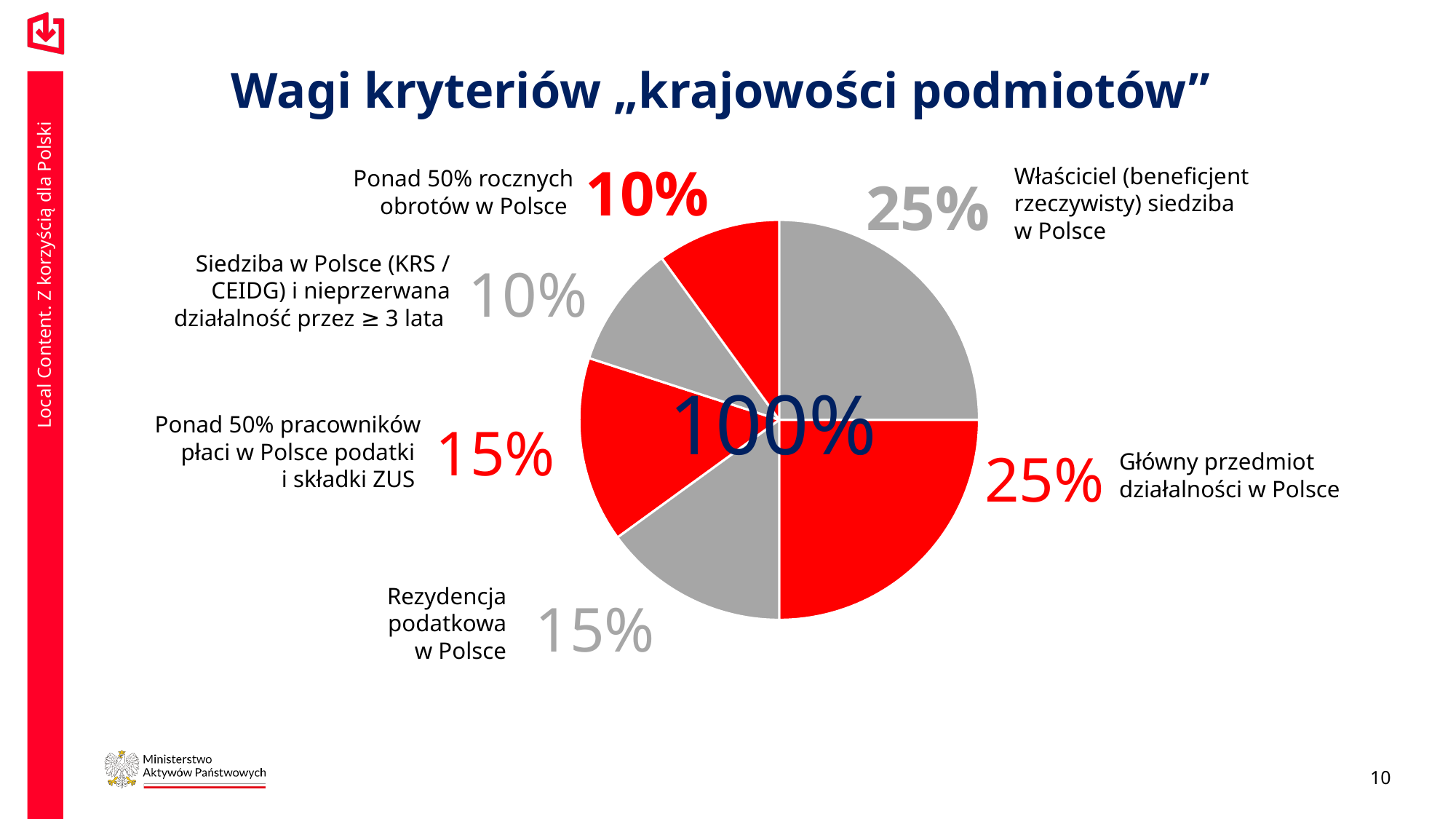
What is the weight shown for "Ponad 50% rocznych obrotów w Polsce"? 10% What is the weight shown for "Właściciel (beneficjent rzeczywisty) siedziba w Polsce"? 25% What is the difference between the weight for "Główny przedmiot działalności w Polsce" and the weight for "Ponad 50% rocznych obrotów w Polsce"? 15% What value is printed in the centre of the pie chart? 100% How many slices does the pie chart have? 6 What kind of chart is shown on the slide? pie chart Which is larger: the weight for "Rezydencja podatkowa w Polsce" or the weight for "Siedziba w Polsce (KRS / CEIDG) i nieprzerwana działalność przez ≥ 3 lata"? Rezydencja podatkowa w Polsce What is the weight shown for "Główny przedmiot działalności w Polsce"? 25% What is the weight shown for "Ponad 50% pracowników płaci w Polsce podatki i składki ZUS"? 15% What is the weight shown for "Rezydencja podatkowa w Polsce"? 15% What is the combined weight of "Właściciel (beneficjent rzeczywisty) siedziba w Polsce" and "Główny przedmiot działalności w Polsce"? 50% What is the weight shown for "Siedziba w Polsce (KRS / CEIDG) i nieprzerwana działalność przez ≥ 3 lata"? 10%